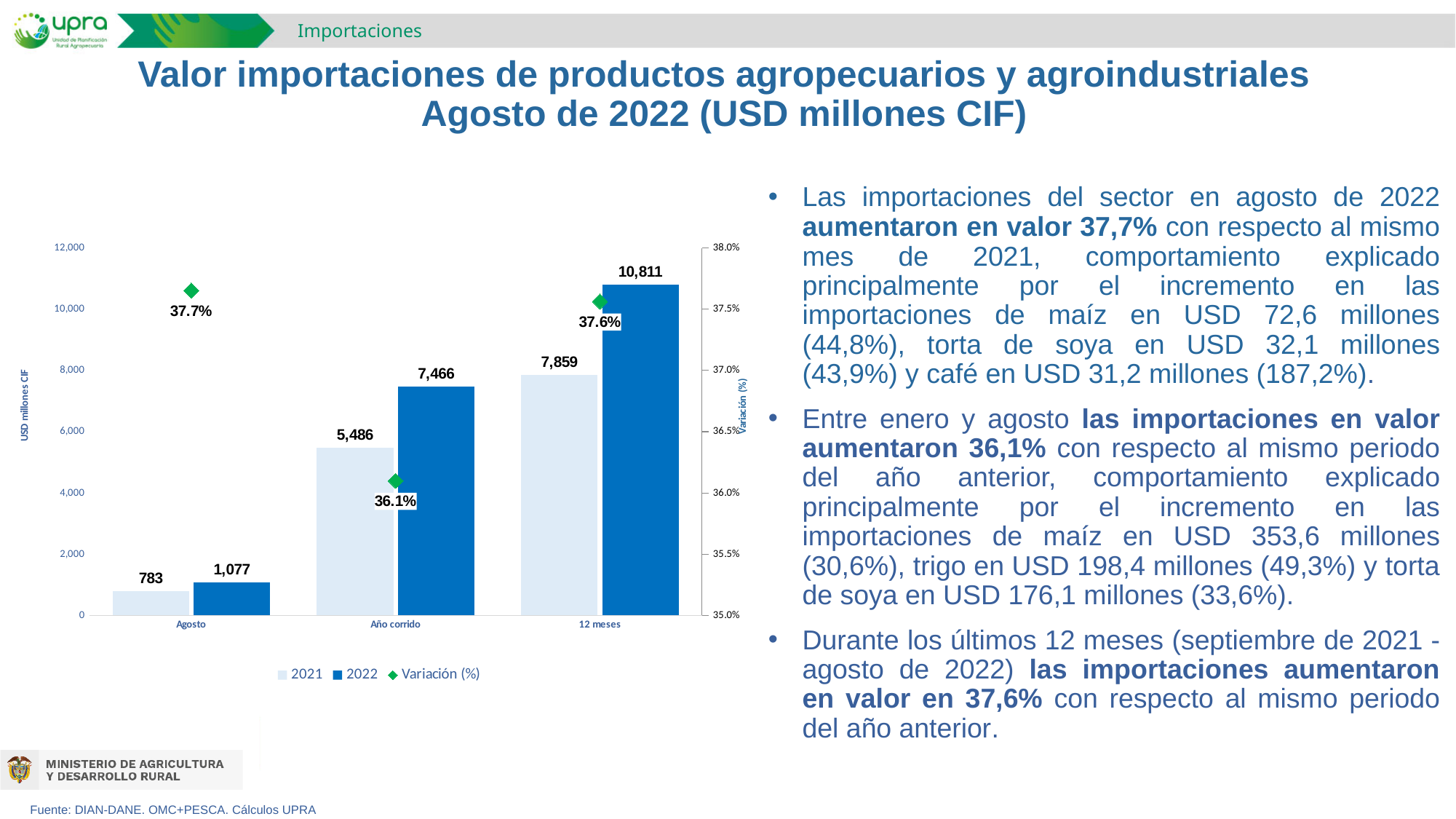
What is the Variación (%) value shown for Año corrido? 36.1% Which category has the highest 2022 value? 12 meses What is the label of the left vertical axis? USD millones CIF What is the difference between the 2022 and 2021 values for 12 meses? 2,952 What kind of chart is shown on the slide? Bar chart with a line/marker series for Variación (%) What is the value for 2022 in the Agosto category? 1,077 Which is larger: the 2022 value for Año corrido or the 2021 value for 12 meses? 2021 value for 12 meses (7,859) What is the value for 2021 in the Año corrido category? 5,486 How many series does the legend list? 3 How many categories are shown on the x axis? 3 Which category has the lowest 2021 value? Agosto What is the Variación (%) value shown for 12 meses? 37.6%